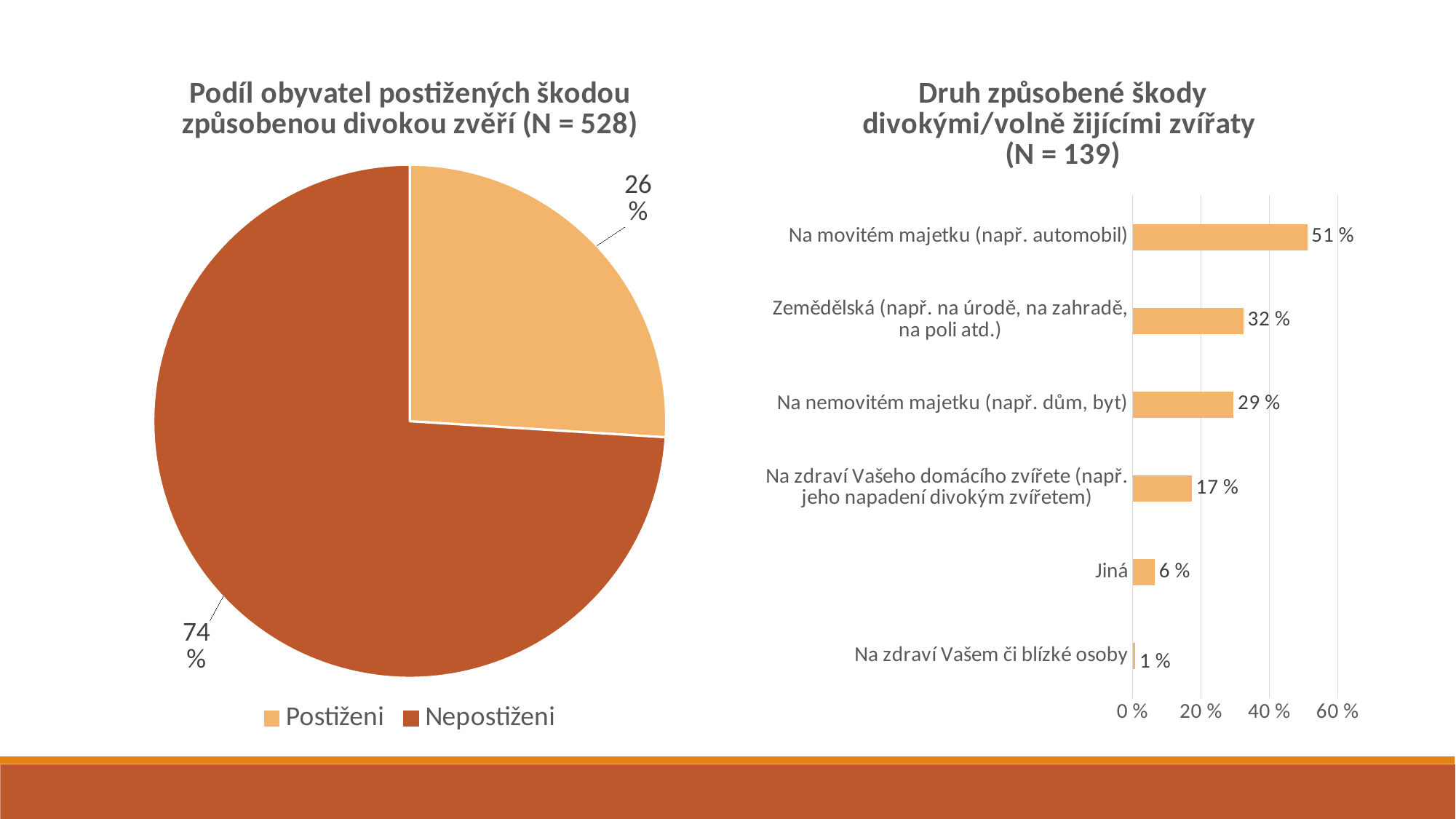
In the bar chart on the right, which category has the highest value? Na movitém majetku (např. automobil) What type of chart is the chart on the right? Bar chart What type of chart is the chart on the left? Pie chart How many entries does the legend of the pie chart on the left list? 2 How many categories does the bar chart on the right show? 6 In the bar chart on the right, what is the value for 'Jiná'? 6 % In the bar chart on the right, what is the difference between the values for 'Zemědělská (např. na úrodě, na zahradě, na poli atd.)' and 'Na nemovitém majetku (např. dům, byt)'? 3 % In the bar chart on the right, what is the value for 'Na movitém majetku (např. automobil)'? 51 % In the bar chart on the right, which category has the lowest value? Na zdraví Vašem či blízké osoby In the pie chart on the left, what share of respondents are 'Nepostiženi'? 74 % In the pie chart on the left, what share of respondents are 'Postiženi'? 26 % In the pie chart on the left, which slice is larger, 'Postiženi' or 'Nepostiženi'? Nepostiženi